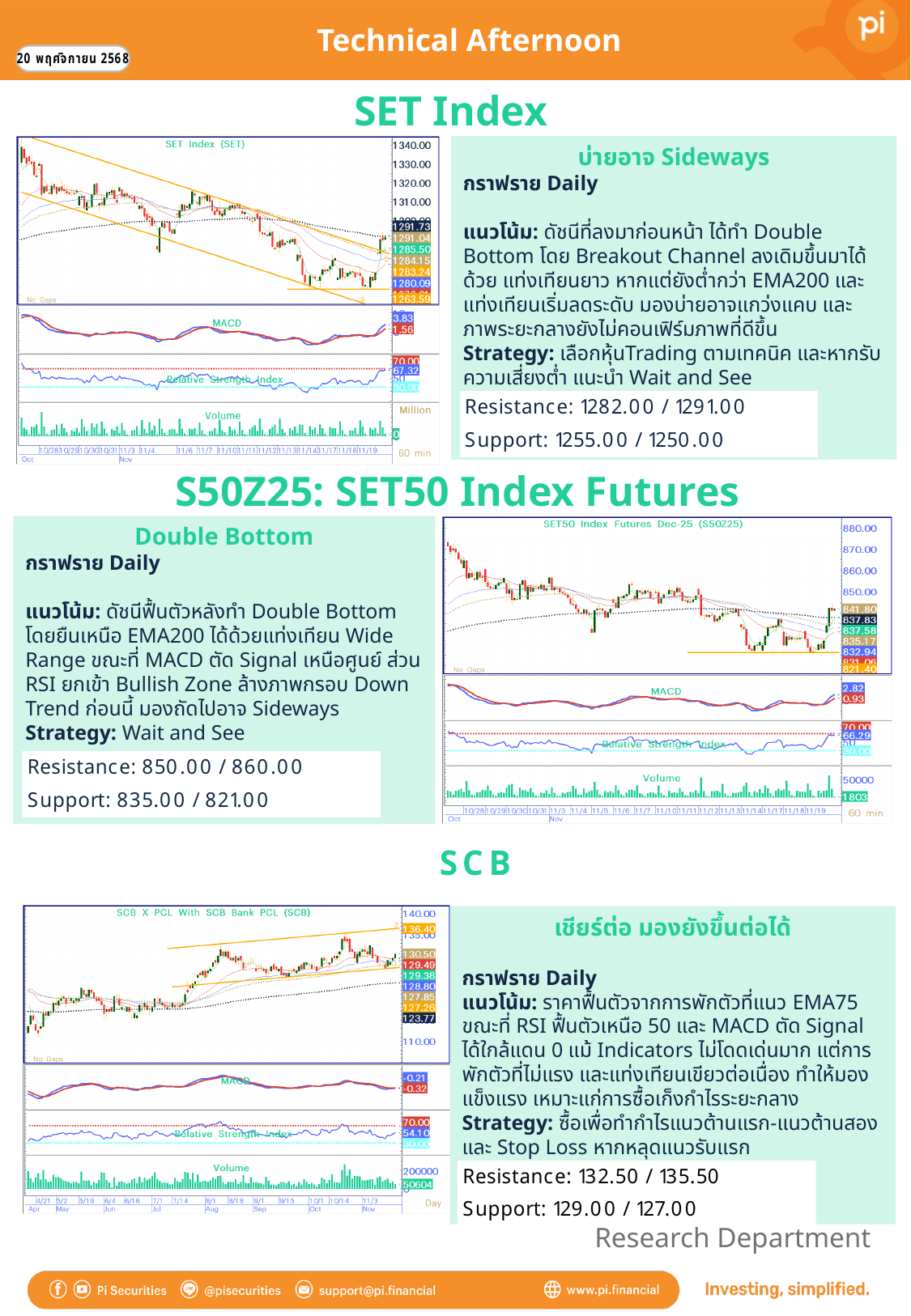
On the SCB chart, what are the two MACD values shown at the right edge? -0.21 and -0.32 On the SCB chart, what is the latest volume value shown? 50604 On the SET Index chart, what is the value shown for the Relative Strength Index? 67.32 On the SCB chart, what is the value shown for the Relative Strength Index? 54.10 What kind of chart is the price panel of the SCB chart? candlestick chart Which chart shows a higher Relative Strength Index value, the SET Index chart or the SCB chart? SET Index On the SET Index chart, what are the two MACD values shown at the right edge? 3.83 and 1.56 On the SET50 Index Futures (S50Z25) chart, what is the value shown for the Relative Strength Index? 66.29 What is the difference between the RSI value on the SET Index chart (67.32) and the RSI value on the SCB chart (54.10)? 13.22 On the SCB chart, does the price generally rise or fall from April to November? rise On the SET Index chart, is the Relative Strength Index value greater or less than 70? less What timeframe is shown at the bottom right of the SET Index chart? 60 min